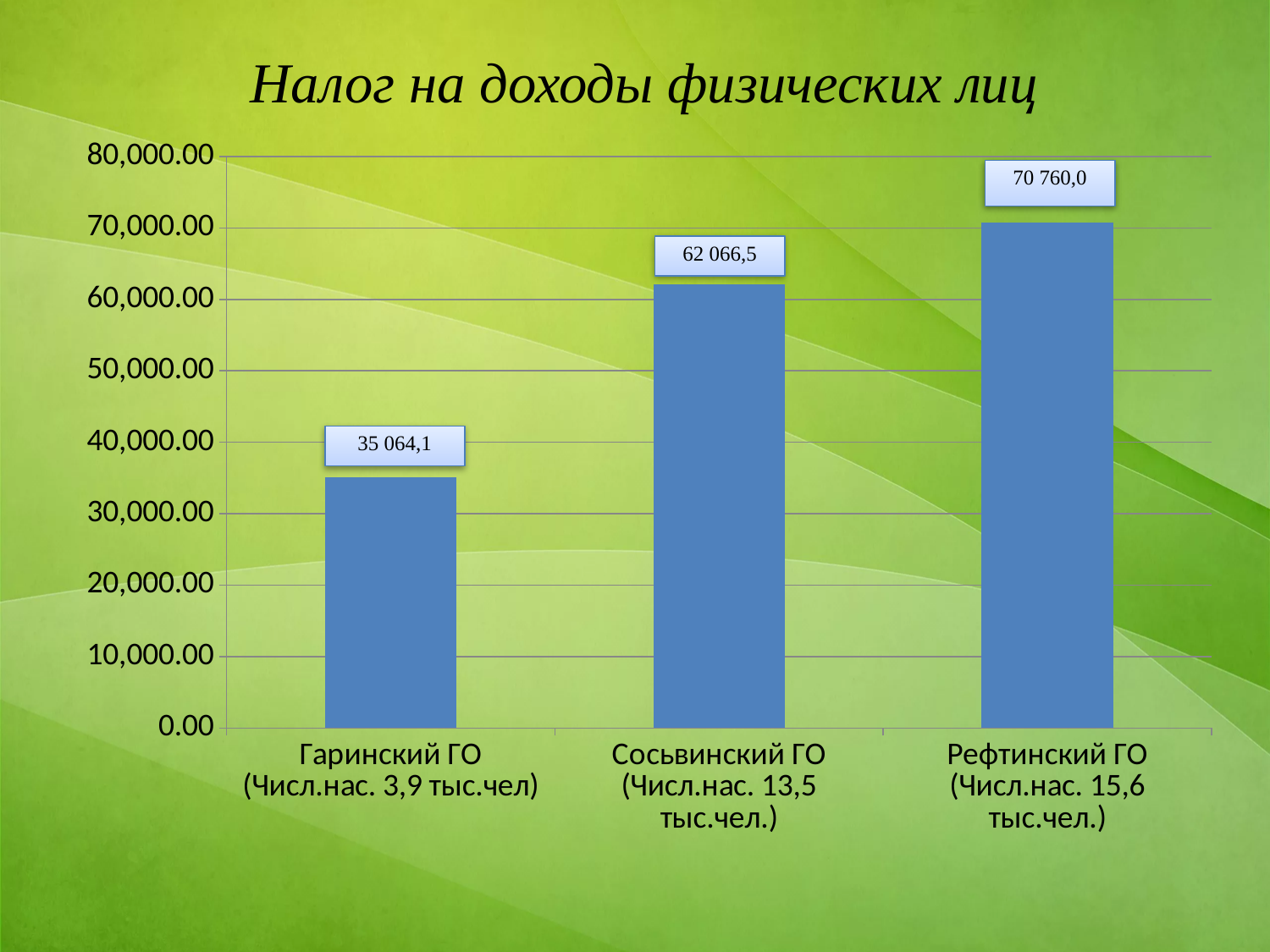
What is the difference between the values for Сосьвинский ГО and Гаринский ГО? 27 002,4 Which category has the highest value? Рефтинский ГО What is the value for Гаринский ГО? 35 064,1 What is the value for Сосьвинский ГО? 62 066,5 Which category has the lowest value? Гаринский ГО How many categories are shown in the chart? 3 Is the value for Рефтинский ГО greater or less than 70,000.00? greater What is the value for Рефтинский ГО? 70 760,0 What is the difference between the values for Рефтинский ГО and Сосьвинский ГО? 8 693,5 Which is larger, the value for Гаринский ГО or the value for Сосьвинский ГО? Сосьвинский ГО What kind of chart is shown on the slide? bar chart What is the title of the chart? Налог на доходы физических лиц